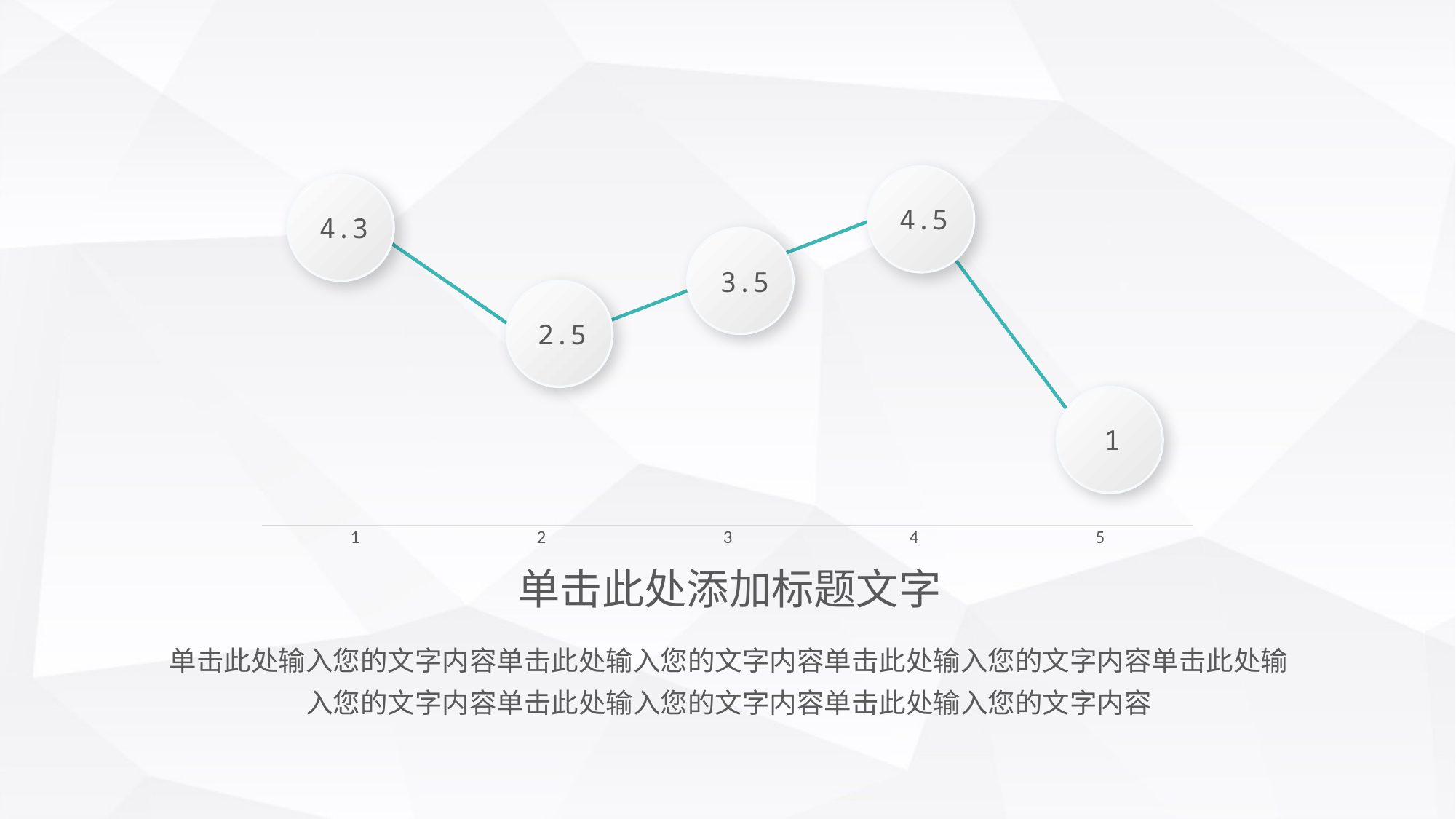
What is the difference between the values at category 4 and category 5? 3.5 How many data points are plotted on the chart? 5 Which category has the highest value? 4 What is the value at category 3? 3.5 Which is larger, the value at category 3 or the value at category 2? category 3 Which category has the lowest value? 5 What kind of chart is shown on the slide? line chart What is the value at category 2? 2.5 What is the value at category 5? 1 What is the difference between the values at category 1 and category 2? 1.8 What is the value at category 1? 4.3 What is the value at category 4? 4.5